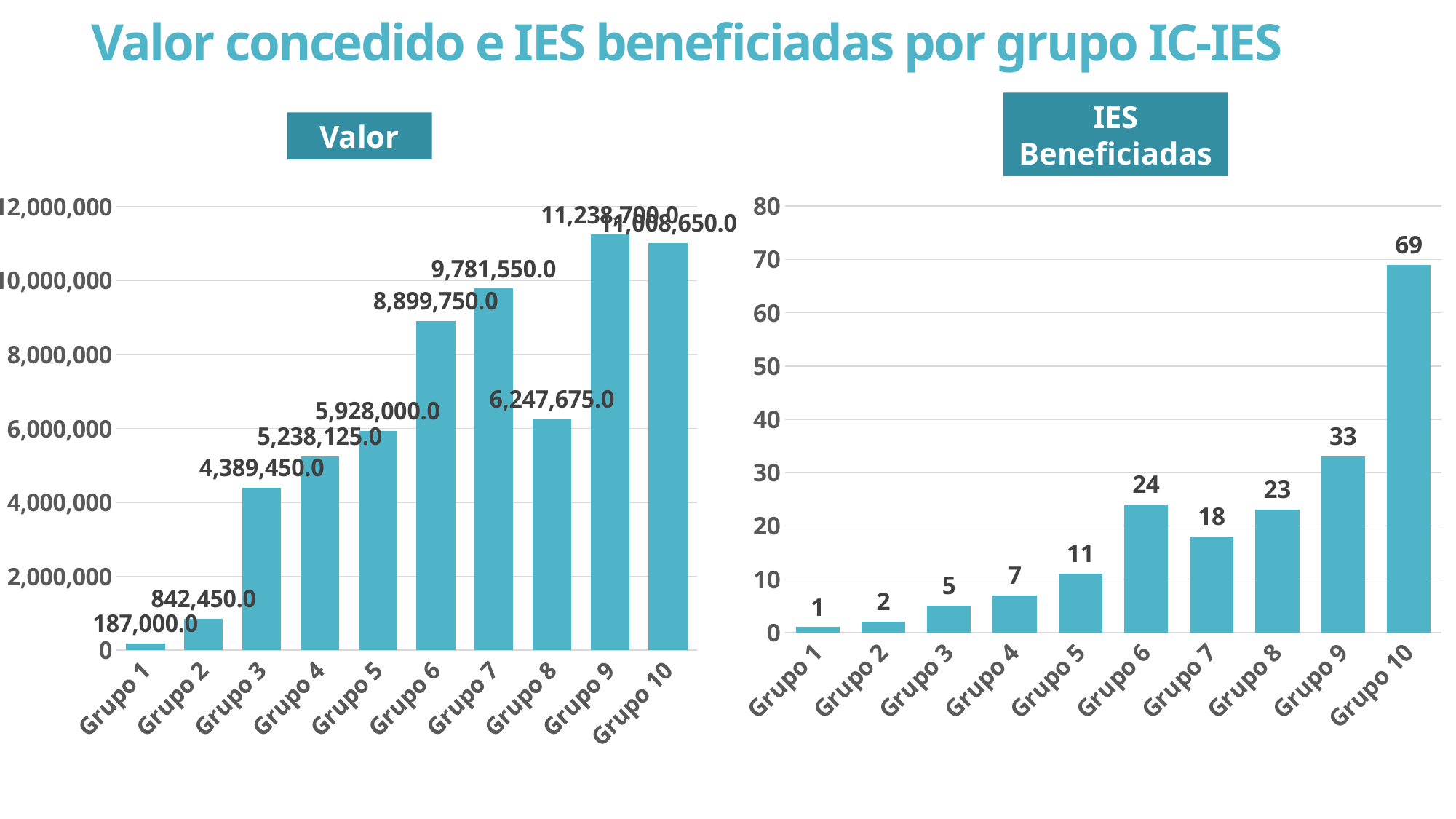
In the Valor chart, what is the difference between the values for Grupo 2 and Grupo 1? 655,450.0 What kind of chart is the Valor chart? bar chart What is the title of the slide containing the two charts? Valor concedido e IES beneficiadas por grupo IC-IES In the IES Beneficiadas chart, what is the difference between the values for Grupo 10 and Grupo 9? 36 In the IES Beneficiadas chart, what is the value for Grupo 6? 24 How many groups are shown in the IES Beneficiadas chart? 10 In the IES Beneficiadas chart, which is larger: the value for Grupo 6 or Grupo 7? Grupo 6 In the Valor chart, is the value for Grupo 3 greater or less than 4,000,000? greater In the Valor chart, which is larger: the value for Grupo 5 or Grupo 8? Grupo 8 In the Valor chart, which group has the lowest value? Grupo 1 In the Valor chart, what is the value for Grupo 7? 9,781,550.0 In the IES Beneficiadas chart, which group has the highest value? Grupo 10